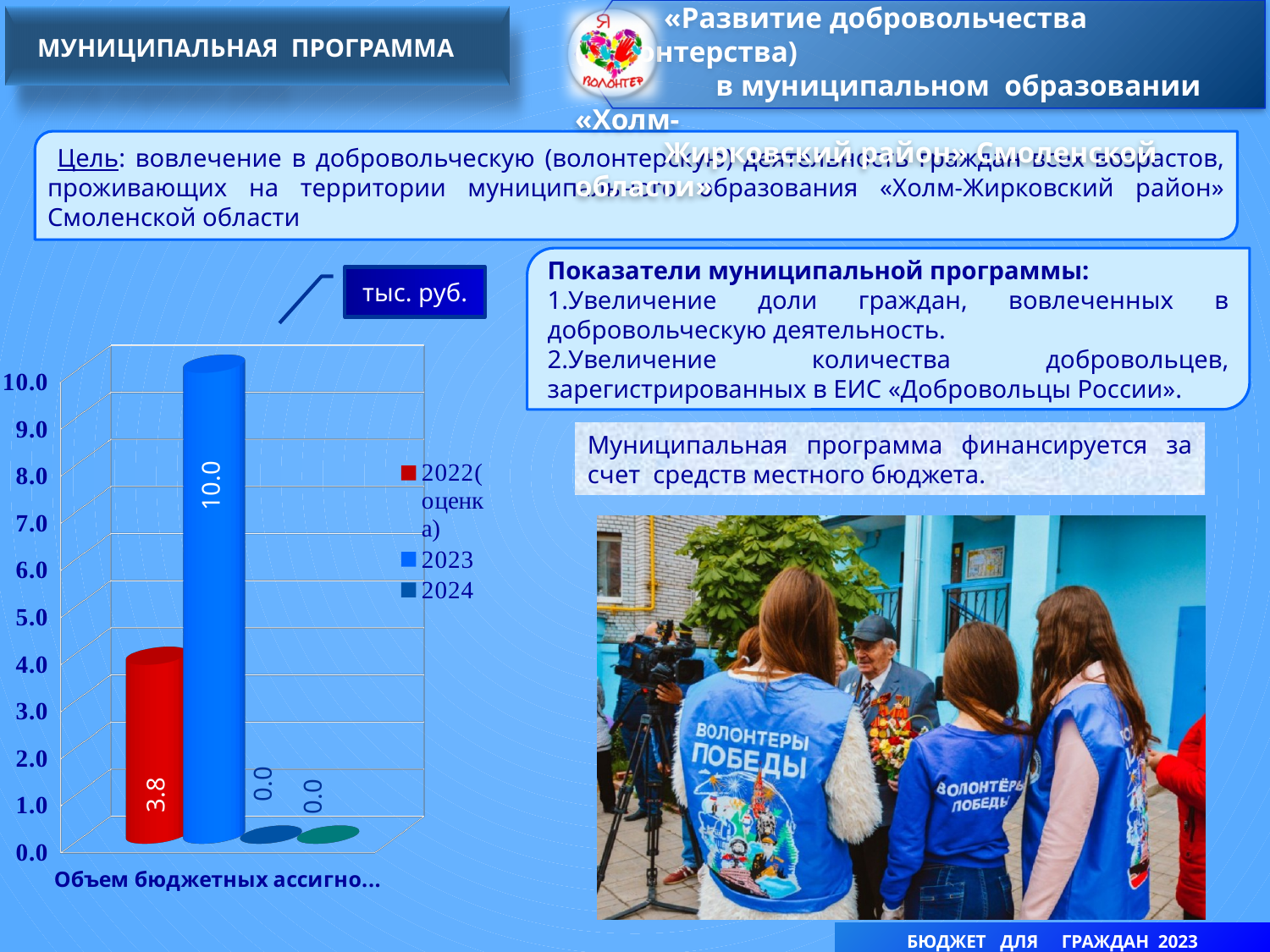
What colour is the bar for 2023 in the chart? blue How many series does the legend of the bar chart list? 3 What is the value for 2023 in the bar chart? 10.0 What is the difference between the 2023 value and the 2022 (оценка) value in the bar chart? 6.2 Which year has the highest value in the bar chart? 2023 What is the value for 2024 in the bar chart? 0.0 What is the value for 2022 (оценка) in the bar chart? 3.8 What unit is indicated in the box above the bar chart? тыс. руб. Which is larger in the bar chart, the value for 2022 (оценка) or the value for 2023? 2023 What kind of chart is shown on the slide? bar chart Is the value for 2022 (оценка) greater or less than 5.0? less How many bars are plotted in the chart? 4